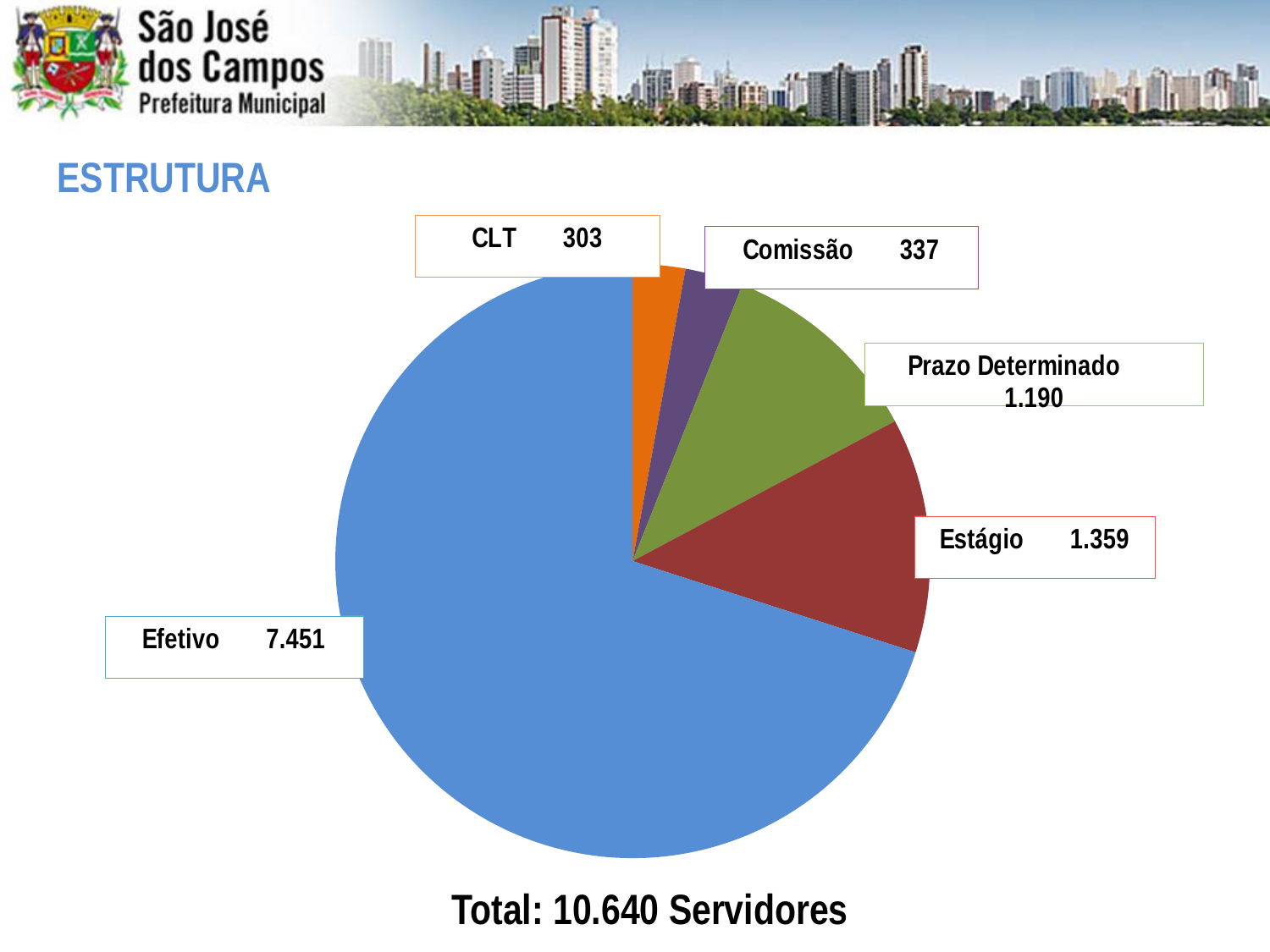
Which category has the largest slice? Efetivo How many slices does the pie chart have? 5 What kind of chart is shown on the slide? pie chart What is the value for CLT? 303 What is the value for Prazo Determinado? 1.190 What is the value for Estágio? 1.359 What is the difference between the values for Estágio and Prazo Determinado? 169 Which is larger, Comissão or CLT? Comissão What is the title of the slide containing the pie chart? ESTRUTURA What is the total number of servidores stated on the slide? 10.640 What is the value for Efetivo? 7.451 Which category has the smallest slice? CLT